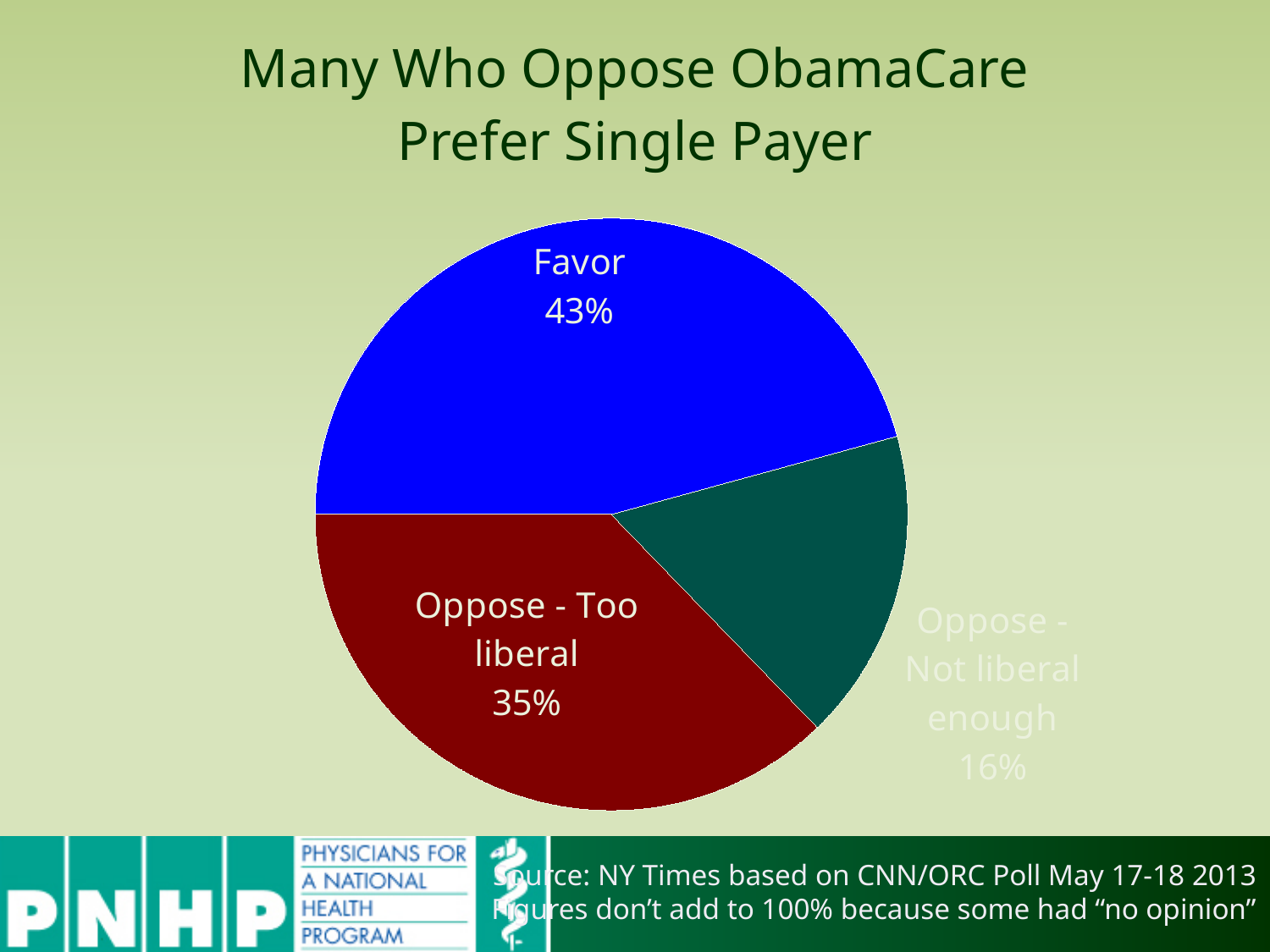
What is the difference in percentage points between the Favor slice and the "Oppose - Too liberal" slice? 8 What percentage is shown for the "Oppose - Too liberal" slice? 35% What percentage is shown for the "Oppose - Not liberal enough" slice? 16% What colour is the Favor slice of the pie? Blue Which slice of the pie is the largest? Favor What kind of chart is shown on the slide? Pie chart How many slices does the pie chart have? 3 Which is larger, the Favor slice or the "Oppose - Too liberal" slice? Favor Which slice of the pie is the smallest? Oppose - Not liberal enough What is the difference in percentage points between the "Oppose - Too liberal" slice and the "Oppose - Not liberal enough" slice? 19 What percentage is shown for the Favor slice? 43% What is the title of the chart on the slide? Many Who Oppose ObamaCare Prefer Single Payer